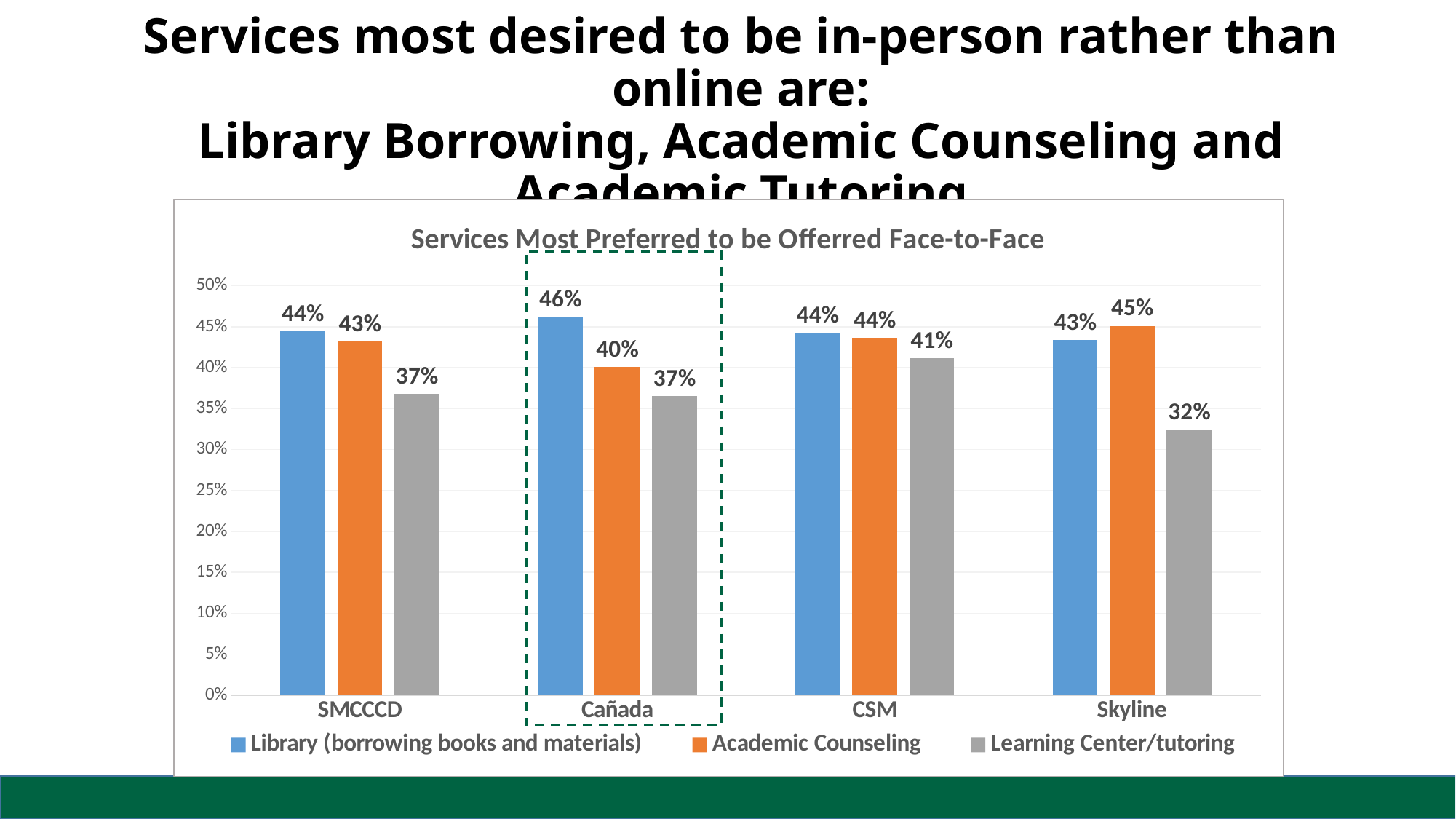
What is the value for Library (borrowing books and materials) at Cañada? 46% How many series does the legend list? 3 What kind of chart is shown? Bar chart Which college has the highest value for Library (borrowing books and materials)? Cañada What is the title of the chart? Services Most Preferred to be Offerred Face-to-Face How many colleges/categories are shown on the x axis? 4 Is the value for Learning Center/tutoring at CSM greater or less than 35%? greater Which college has the lowest value for Learning Center/tutoring? Skyline What is the difference between the Library and Learning Center/tutoring values at Skyline? 11% Which is larger at Skyline: Academic Counseling or Library (borrowing books and materials)? Academic Counseling What is the value for Academic Counseling at CSM? 44% What is the value for Learning Center/tutoring at Skyline? 32%